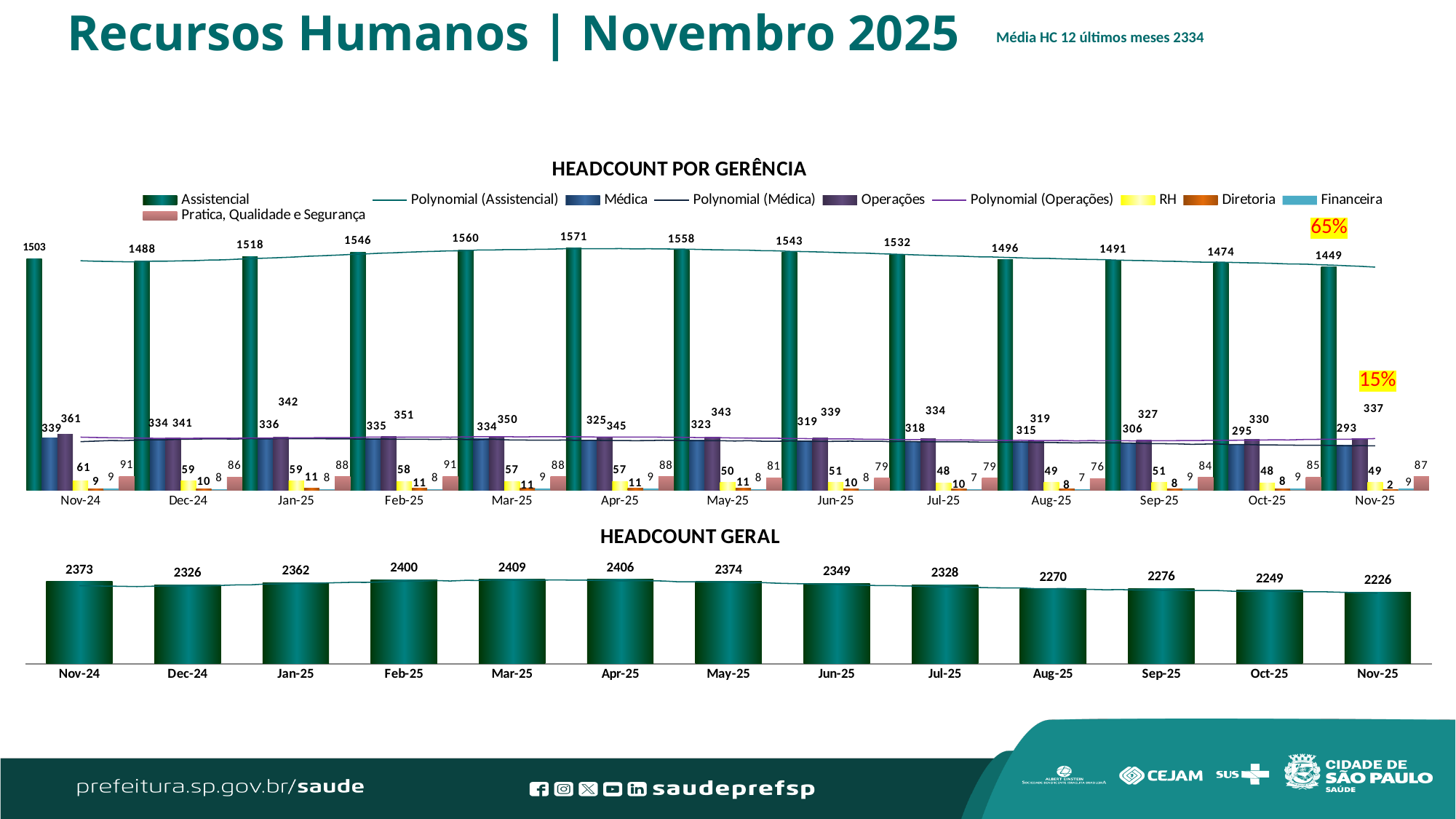
In the HEADCOUNT POR GERÊNCIA chart, in which month is the Operações value highest? Nov-24 In the HEADCOUNT POR GERÊNCIA chart, what is the Médica value for Nov-25? 293 In the HEADCOUNT POR GERÊNCIA chart, what is the Assistencial value for Apr-25? 1571 In the HEADCOUNT GERAL chart, what is the value for Mar-25? 2409 In the HEADCOUNT GERAL chart, which month has the highest headcount? Mar-25 In the HEADCOUNT POR GERÊNCIA chart, what is the Diretoria value for Nov-25? 2 In the HEADCOUNT POR GERÊNCIA chart, which is larger for Nov-25: Médica or Operações? Operações What kind of chart is the HEADCOUNT GERAL chart? bar chart How many months are plotted in the HEADCOUNT GERAL chart? 13 In the HEADCOUNT GERAL chart, which month has the lowest headcount? Nov-25 In the HEADCOUNT GERAL chart, what is the difference between the Nov-24 value and the Nov-25 value? 147 In the HEADCOUNT POR GERÊNCIA chart, does the Assistencial value rise or fall from Apr-25 to Nov-25? fall